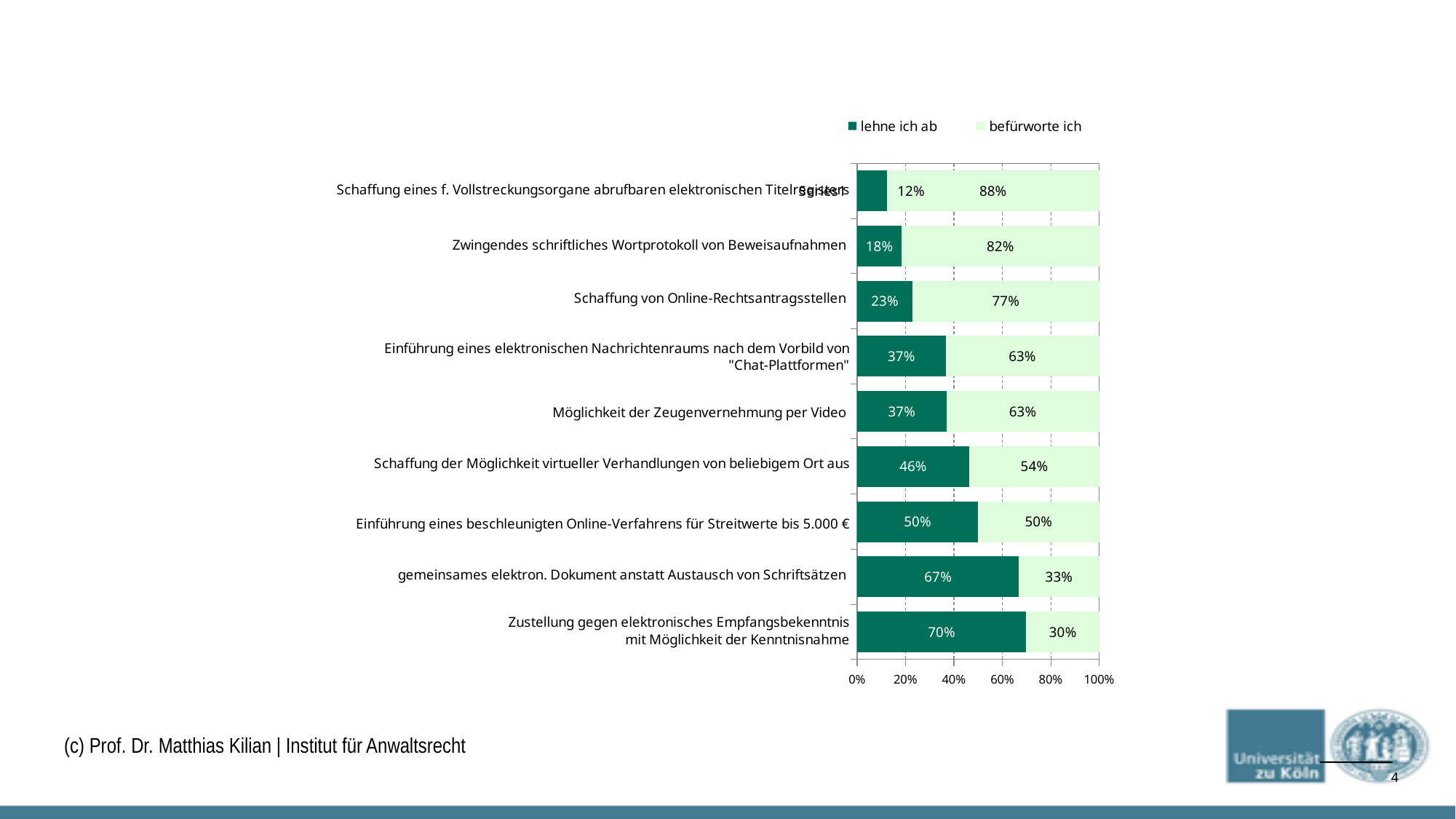
What is the "lehne ich ab" value for "Möglichkeit der Zeugenvernehmung per Video"? 37% What is the "befürworte ich" value for "Schaffung von Online-Rechtsantragsstellen"? 77% What is the "befürworte ich" value for "Zwingendes schriftliches Wortprotokoll von Beweisaufnahmen"? 82% What is the difference between the "befürworte ich" values for "Schaffung von Online-Rechtsantragsstellen" and "Schaffung der Möglichkeit virtueller Verhandlungen von beliebigem Ort aus"? 23% What is the "lehne ich ab" value for "gemeinsames elektron. Dokument anstatt Austausch von Schriftsätzen"? 67% What is the total of the stacked bar for "Zustellung gegen elektronisches Empfangsbekenntnis mit Möglichkeit der Kenntnisnahme"? 100% What kind of chart is shown on the slide? Stacked bar chart Which is larger: the "lehne ich ab" value for "Einführung eines beschleunigten Online-Verfahrens für Streitwerte bis 5.000 €" or for "Schaffung der Möglichkeit virtueller Verhandlungen von beliebigem Ort aus"? Einführung eines beschleunigten Online-Verfahrens für Streitwerte bis 5.000 € How many categories are plotted in the chart? 9 How many series does the legend list? 2 Which category has the highest "lehne ich ab" value? Zustellung gegen elektronisches Empfangsbekenntnis mit Möglichkeit der Kenntnisnahme Which legend entry is shown in dark green? lehne ich ab